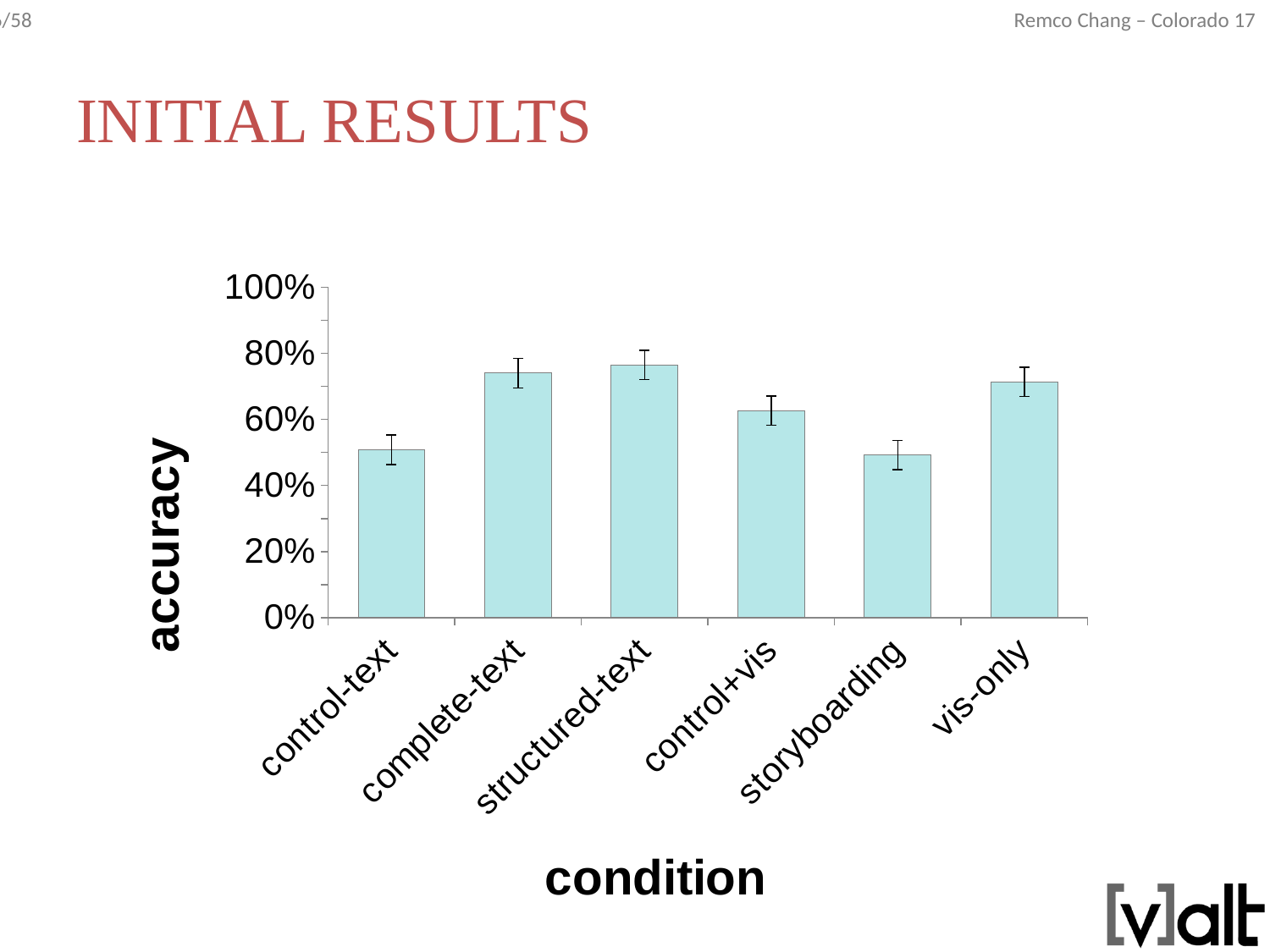
What is the label of the x axis of the chart? condition What kind of chart is shown on the slide? bar chart Which condition has the higher accuracy, complete-text or control+vis? complete-text How many conditions are plotted on the x axis of the chart? 6 Is the accuracy for vis-only greater or less than 60%? greater Is the accuracy for storyboarding greater or less than 60%? less Is the accuracy for control-text greater or less than 60%? less Which condition has the higher accuracy, vis-only or storyboarding? vis-only What is the label of the y axis of the chart? accuracy Which condition has the higher accuracy, structured-text or control-text? structured-text